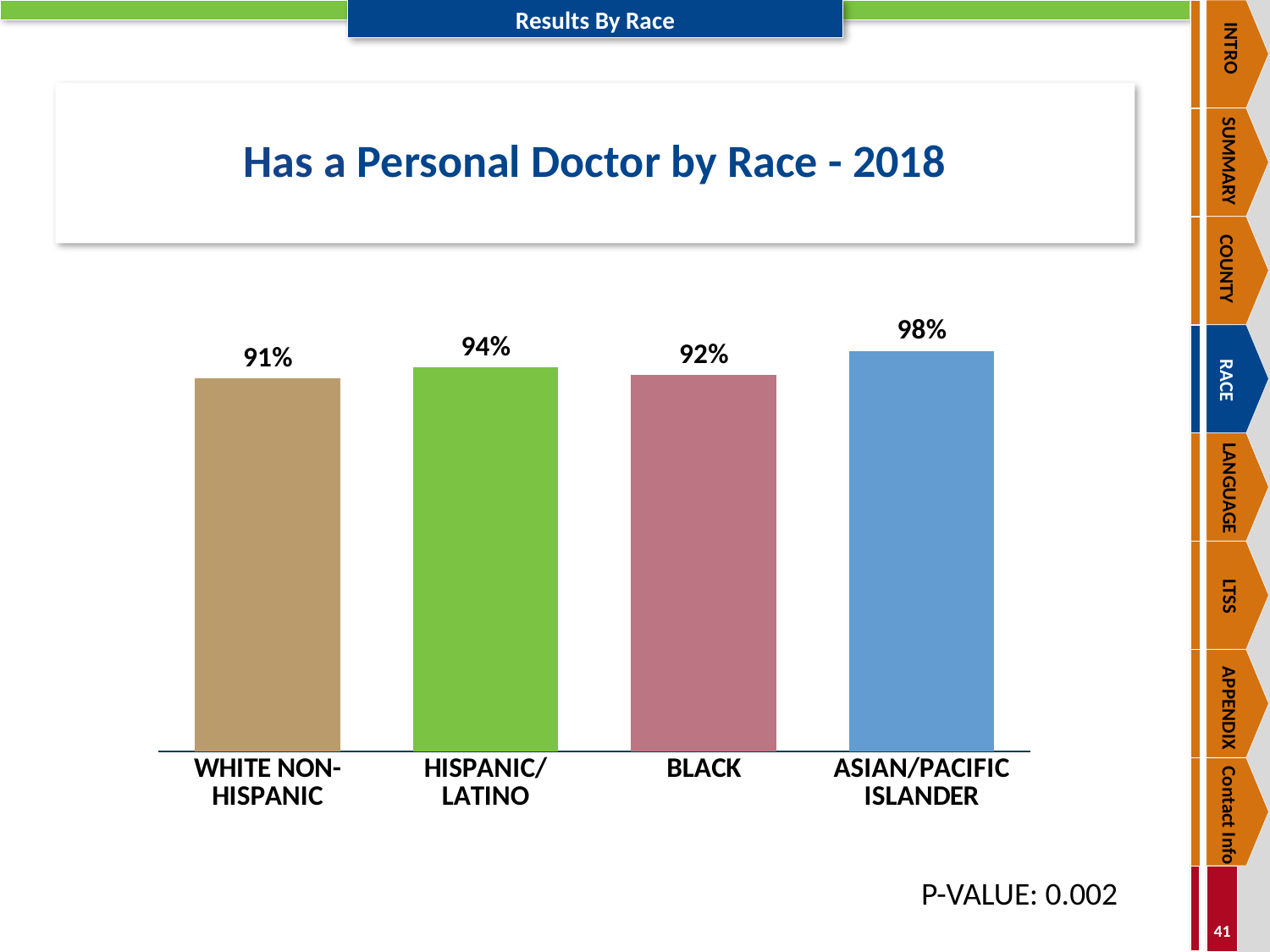
Which is larger, the value for Hispanic/Latino or the value for Black? Hispanic/Latino What is the difference in percentage points between Hispanic/Latino and Black? 2 What is the difference in percentage points between Asian/Pacific Islander and White Non-Hispanic? 7 What is the value shown for Black? 92% What is the title of the chart? Has a Personal Doctor by Race - 2018 Which race group has the lowest percentage with a personal doctor? White Non-Hispanic What is the value shown for Asian/Pacific Islander? 98% Which race group has the highest percentage with a personal doctor? Asian/Pacific Islander How many race categories are shown in the chart? 4 What percentage of White Non-Hispanic respondents has a personal doctor? 91% What is the value shown for Hispanic/Latino? 94% What kind of chart is shown on the slide? Bar chart